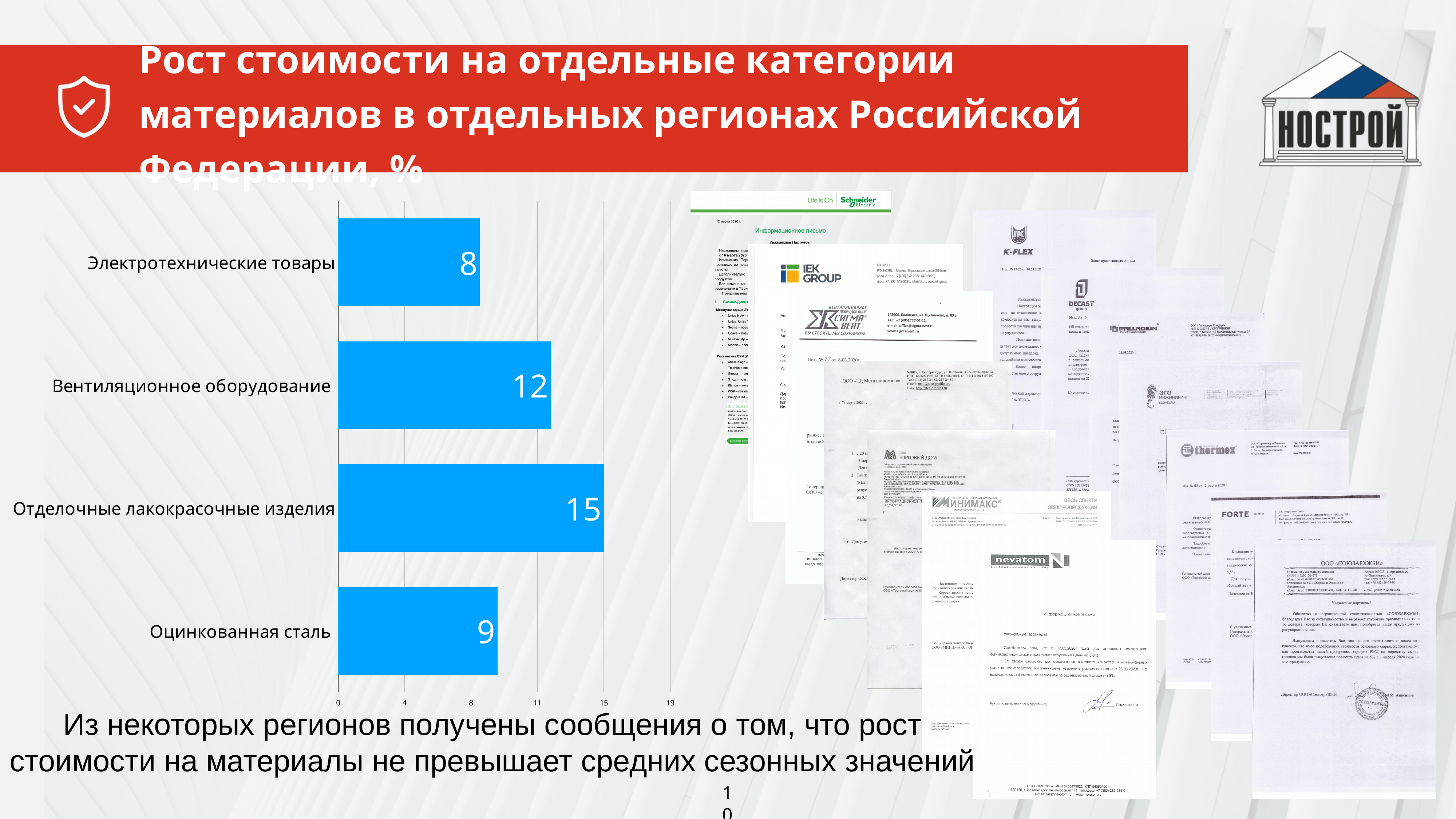
Which category has the lowest value? Электротехнические товары What is the difference between the values for Вентиляционное оборудование and Оцинкованная сталь? 3 What kind of chart is shown on the slide? bar chart What is the difference between the values for Отделочные лакокрасочные изделия and Электротехнические товары? 7 What is the value for Оцинкованная сталь? 9 What is the value for Отделочные лакокрасочные изделия? 15 Which category has the highest value? Отделочные лакокрасочные изделия How many categories are shown in the chart? 4 Which is larger: the value for Вентиляционное оборудование or the value for Оцинкованная сталь? Вентиляционное оборудование What is the value for Вентиляционное оборудование? 12 What is the value for Электротехнические товары? 8 Is the value for Оцинкованная сталь greater or less than 11? less